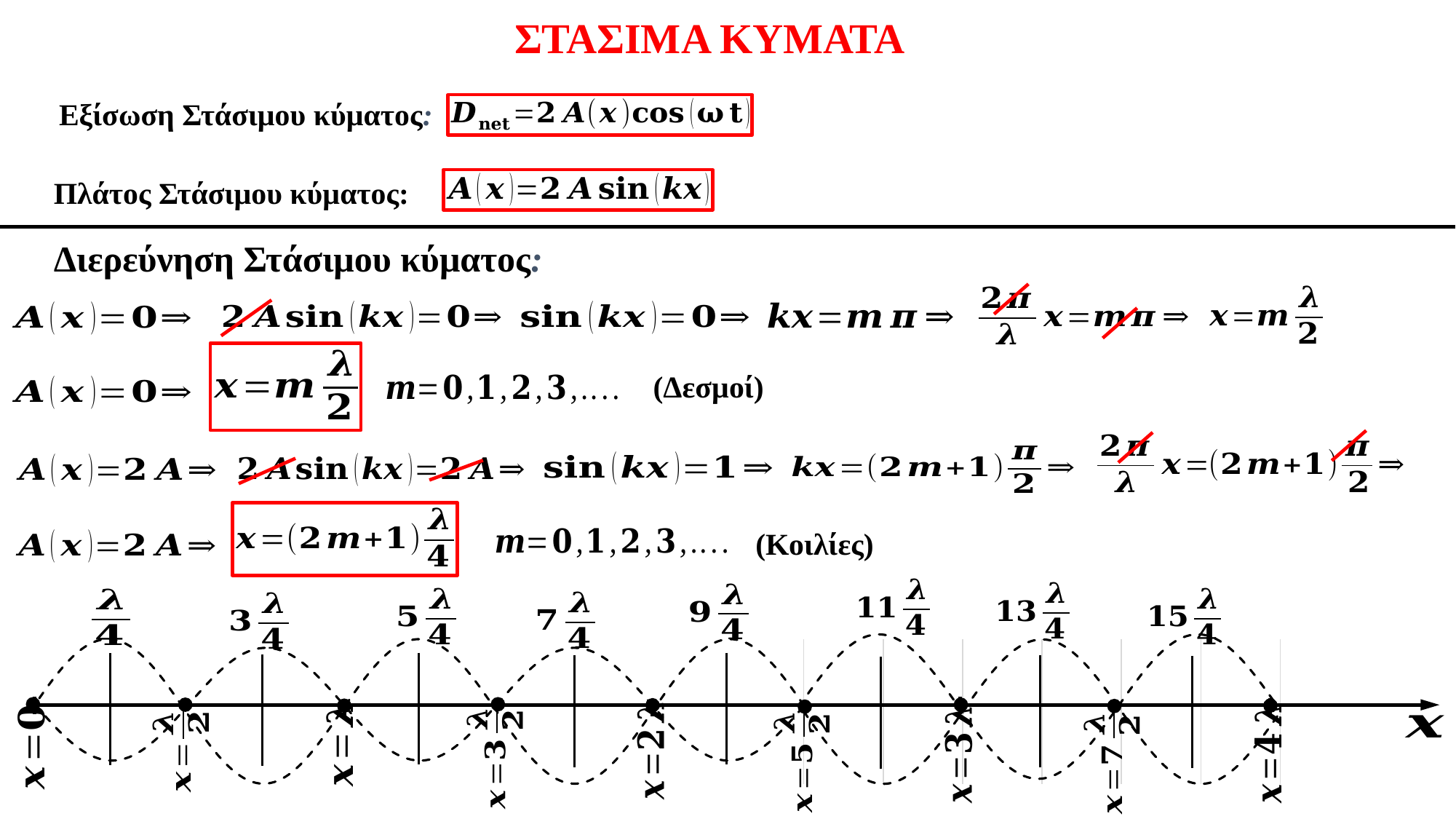
Is the wave envelope in the standing wave diagram drawn with a solid or a dashed line? dashed What is the x position of the rightmost node marked on the standing wave diagram? x=4λ What is the x position of the first antinode labelled on the standing wave diagram? λ/4 How many node points (black dots) are marked on the x axis of the standing wave diagram? 9 What label is written at the right end of the horizontal axis of the standing wave diagram? x What is the x position of the node immediately after x=0 on the standing wave diagram? x=λ/2 What is the label of the last antinode on the right of the standing wave diagram? 15 λ/4 What kind of graphic is shown at the bottom of the slide? A standing wave diagram (dashed wave envelope along an x axis) How many antinode positions are labelled above the standing wave diagram? 8